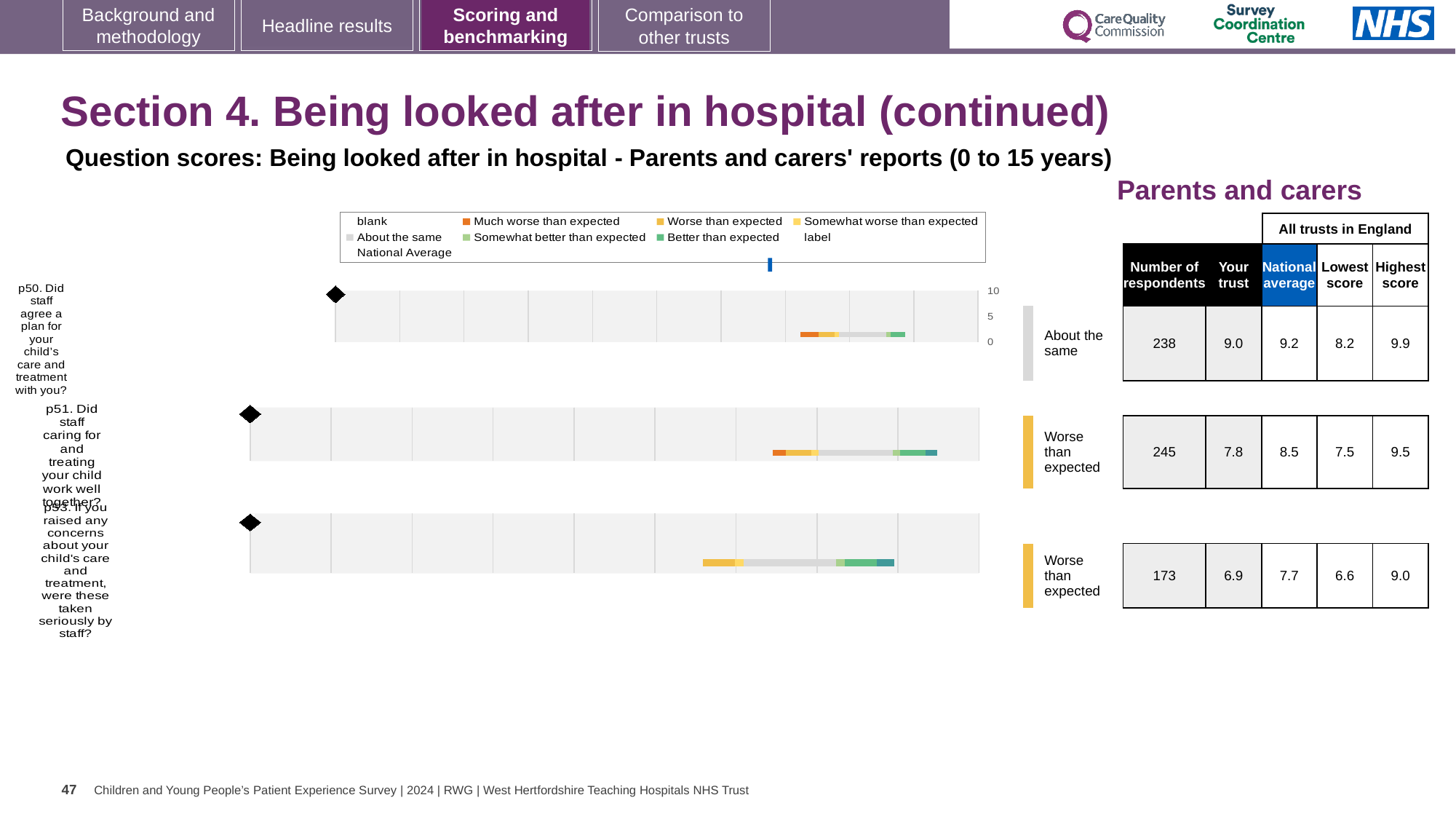
Which question has the lowest 'Your trust' score in the table? p53 What kind of chart is used to show the question scores on this slide? bar chart How many survey questions are plotted on this slide? 3 In the table, what is the 'Your trust' score for p51 (Did staff caring for and treating your child work well together?)? 7.8 Which question has the highest 'Your trust' score in the table? p50 For p50, what is the difference between the national average and the 'Your trust' score? 0.2 For p51, which is larger: the 'Your trust' score or the national average? National average What benchmark category label is shown next to the p50 chart? About the same In the table, what is the highest score among all trusts in England for p51? 9.5 In the table, what is the national average for p53 (If you raised any concerns about your child's care and treatment, were these taken seriously by staff?)? 7.7 In the table, how many respondents are listed for p50 (Did staff agree a plan for your child's care and treatment with you?)? 238